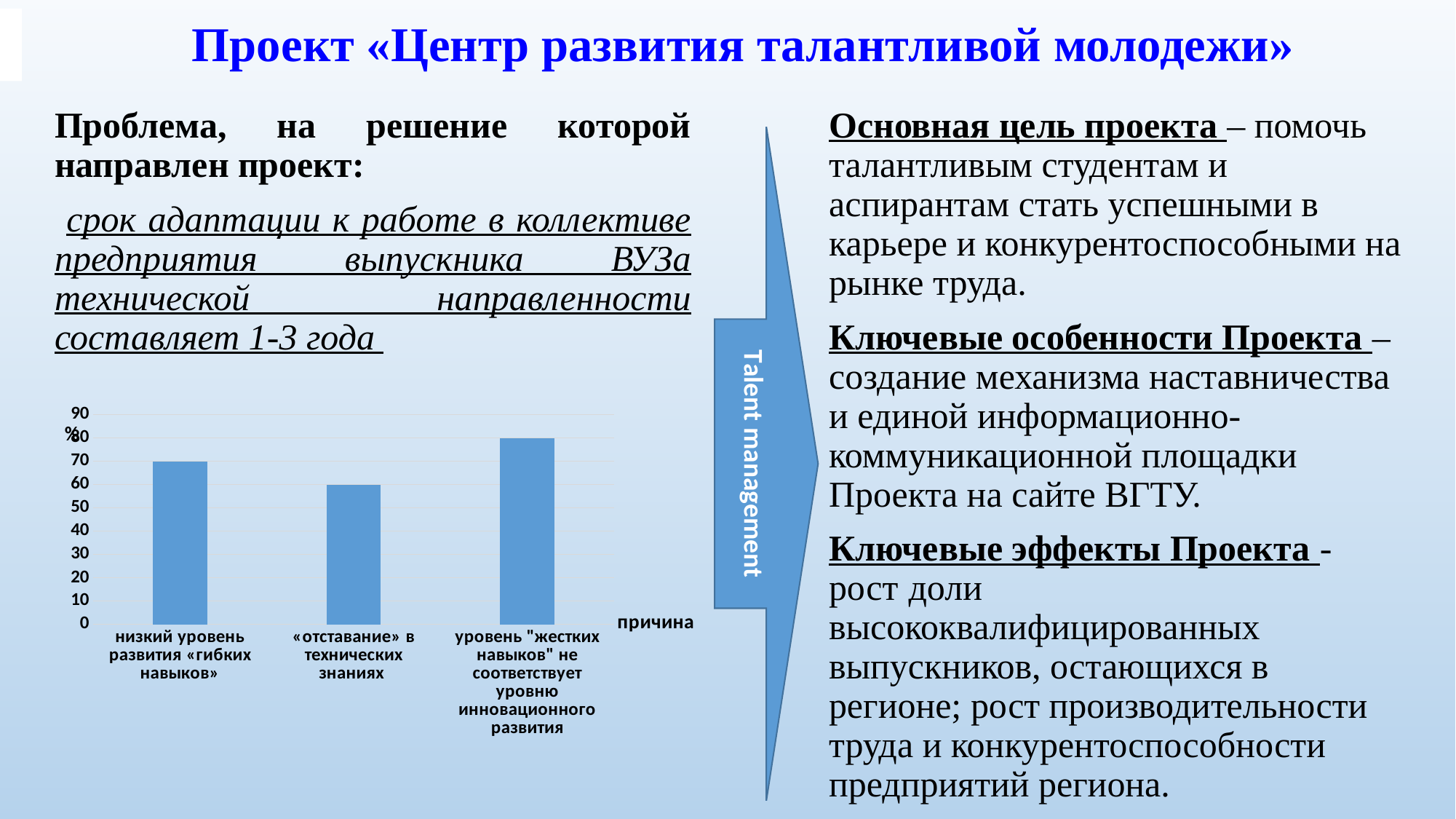
What is the difference between the values for «уровень "жестких навыков" не соответствует уровню инновационного развития» and ««отставание» в технических знаниях»? 20 What is the value for «низкий уровень развития «гибких навыков»»? 70 What is the value for «уровень "жестких навыков" не соответствует уровню инновационного развития»? 80 Is the value for ««отставание» в технических знаниях» greater or less than 70? less Which category has the lowest bar? «отставание» в технических знаниях What is the value for ««отставание» в технических знаниях»? 60 Which category has the highest bar? уровень "жестких навыков" не соответствует уровню инновационного развития What is the maximum value shown on the vertical axis of the chart? 90 What is the label on the horizontal axis of the chart? причина Which is larger: the value for «низкий уровень развития «гибких навыков»» or for ««отставание» в технических знаниях»? низкий уровень развития «гибких навыков» What kind of chart is shown on the slide? bar chart How many categories (причины) are plotted in the bar chart? 3